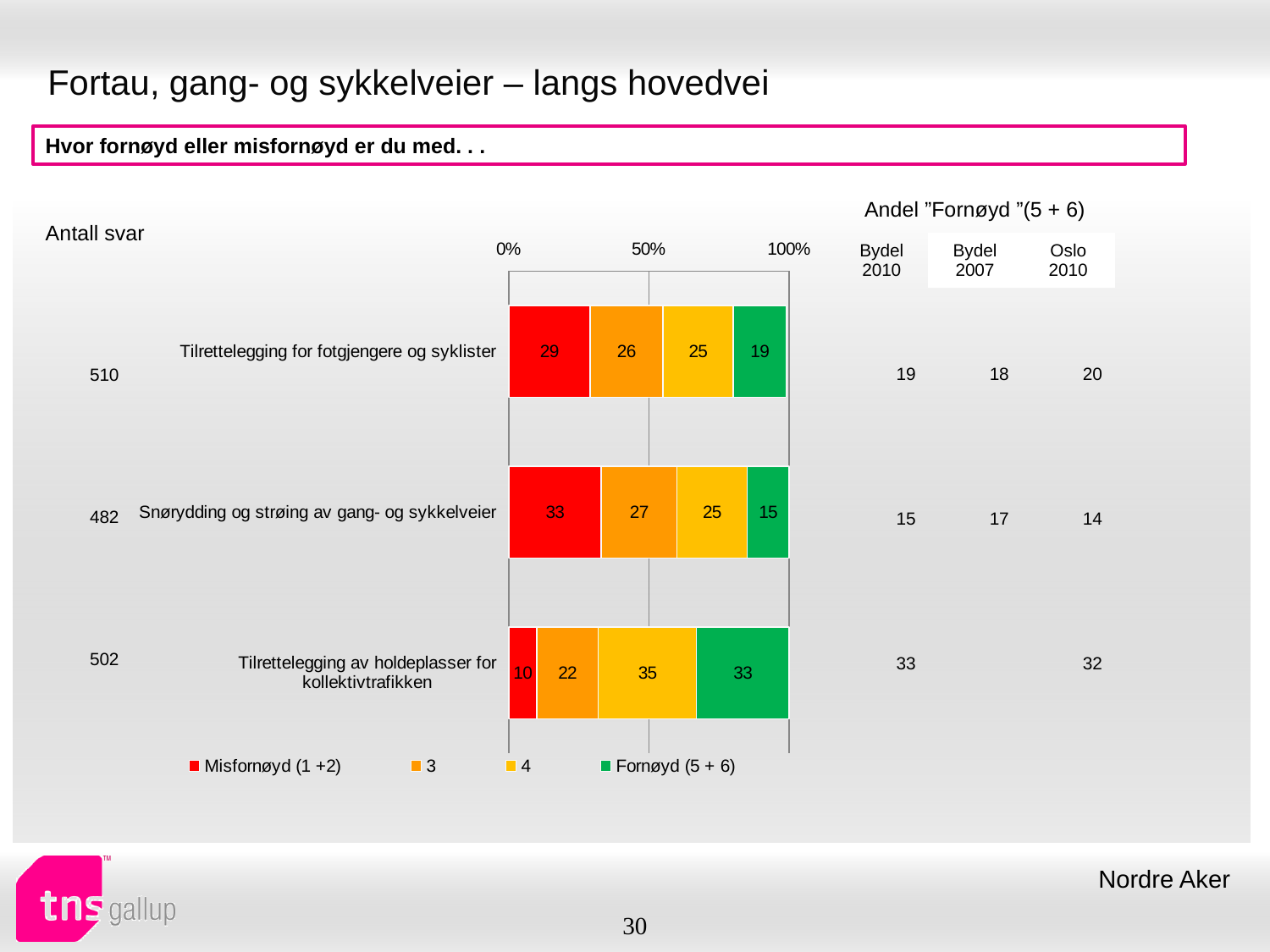
What is the value of the "3" segment for "Tilrettelegging for fotgjengere og syklister"? 26 Which is larger: the "4" segment for "Tilrettelegging av holdeplasser for kollektivtrafikken" or the "4" segment for "Snørydding og strøing av gang- og sykkelveier"? Tilrettelegging av holdeplasser for kollektivtrafikken Which category has the highest "Fornøyd (5 + 6)" value? Tilrettelegging av holdeplasser for kollektivtrafikken What is the value of the "Fornøyd (5 + 6)" segment for "Tilrettelegging av holdeplasser for kollektivtrafikken"? 33 What colour represents the "Fornøyd (5 + 6)" series in the chart? Green What kind of chart is shown on the slide? Stacked bar chart How many series does the chart legend list? 4 What is the total of the stacked bar for "Tilrettelegging for fotgjengere og syklister"? 99 What is the difference between the "Misfornøyd (1 +2)" values for "Snørydding og strøing av gang- og sykkelveier" and "Tilrettelegging for fotgjengere og syklister"? 4 How many categories are plotted in the chart? 3 Which category has the lowest "Misfornøyd (1 +2)" value? Tilrettelegging av holdeplasser for kollektivtrafikken What is the value of the "Misfornøyd (1 +2)" segment for "Snørydding og strøing av gang- og sykkelveier"? 33